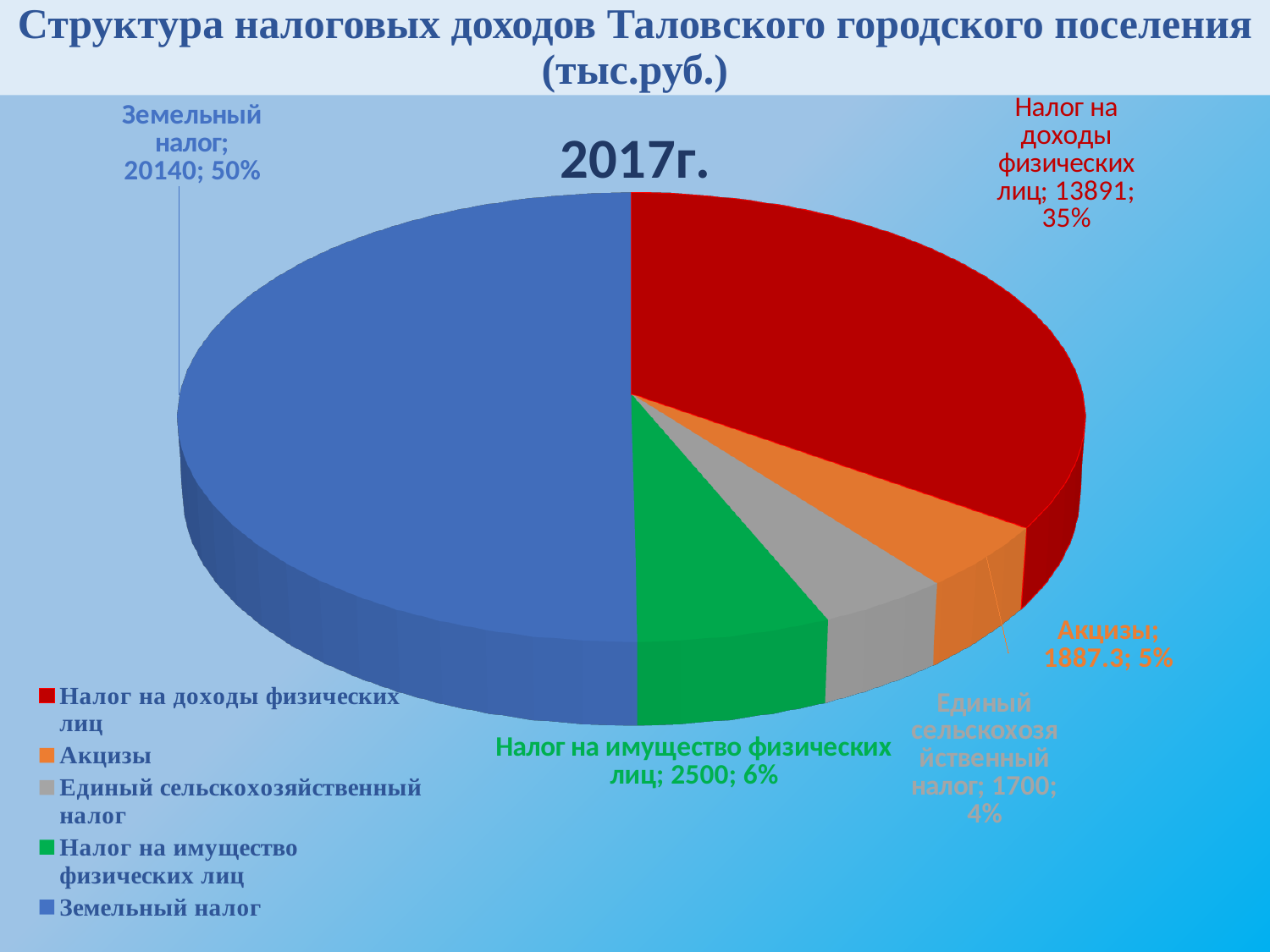
Which category has the smallest slice? Единый сельскохозяйственный налог What is the value for Земельный налог? 20140 What kind of chart is shown on the slide? pie chart Which category has the largest slice? Земельный налог What is the value for Налог на доходы физических лиц? 13891 What share of the pie does Земельный налог represent? 50% What is the difference between the values for Земельный налог and Налог на доходы физических лиц? 6249 What share of the pie does Единый сельскохозяйственный налог represent? 4% What is the value for Налог на имущество физических лиц? 2500 Which is larger, the value for Налог на имущество физических лиц or the value for Акцизы? Налог на имущество физических лиц What is the value for Акцизы? 1887.3 How many categories does the pie chart have? 5